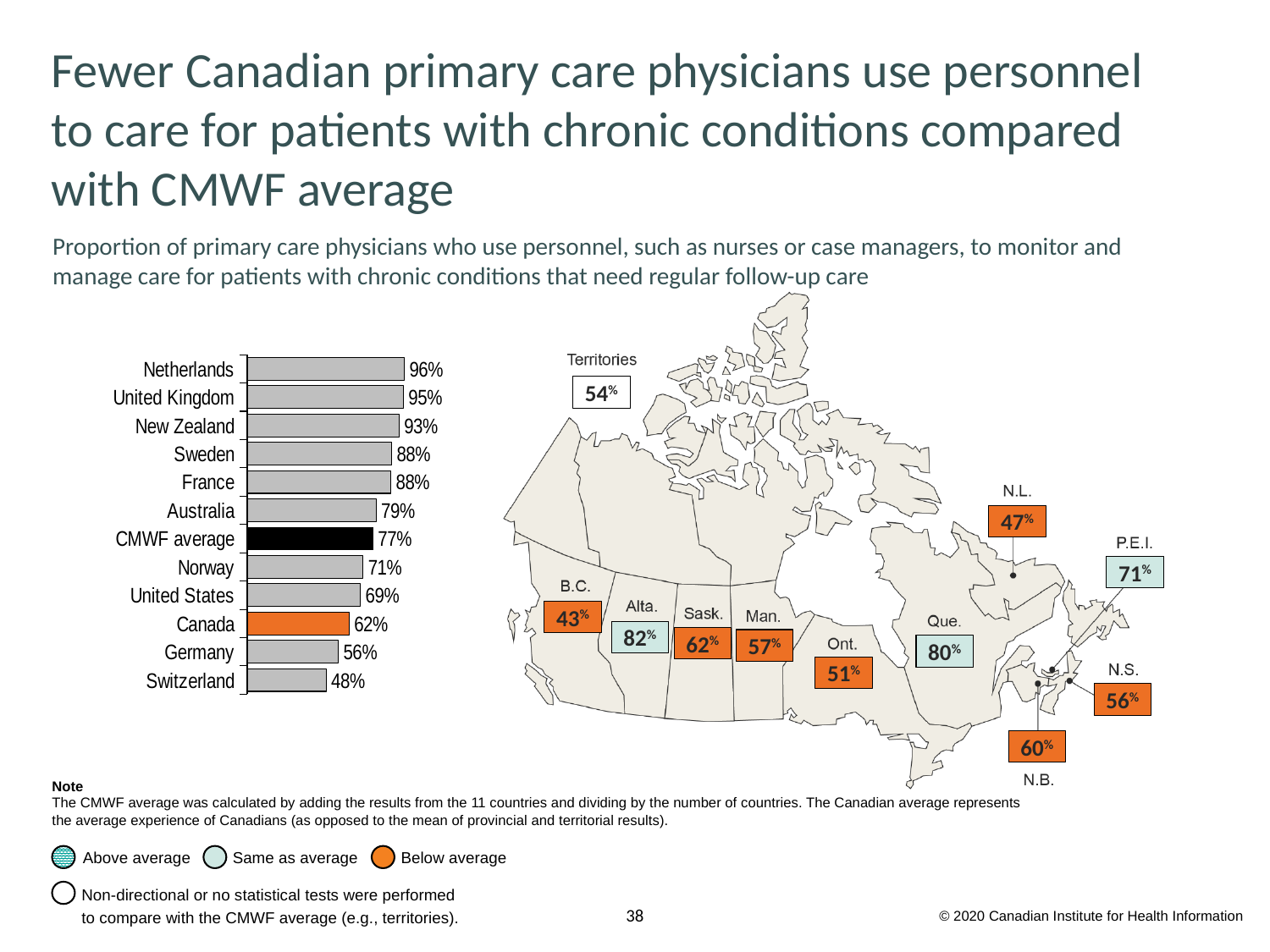
On the map of Canada, what is the value for Alta.? 82% On the map of Canada, which province has the lowest value? B.C. In the bar chart, what colour is the bar for Canada? Orange In the bar chart, which country has the lowest value? Switzerland In the bar chart, which is larger, the value for Norway or the value for Germany? Norway In the bar chart, what is the value for Canada? 62% In the bar chart, do the values rise or fall from the top bar to the bottom bar? Fall What kind of chart is the chart on the left of the slide? Bar chart In the bar chart, what is the difference between the CMWF average and Canada? 15% How many bars are shown in the bar chart? 12 In the bar chart, which country has the highest value? Netherlands In the bar chart, what is the value for the CMWF average? 77%